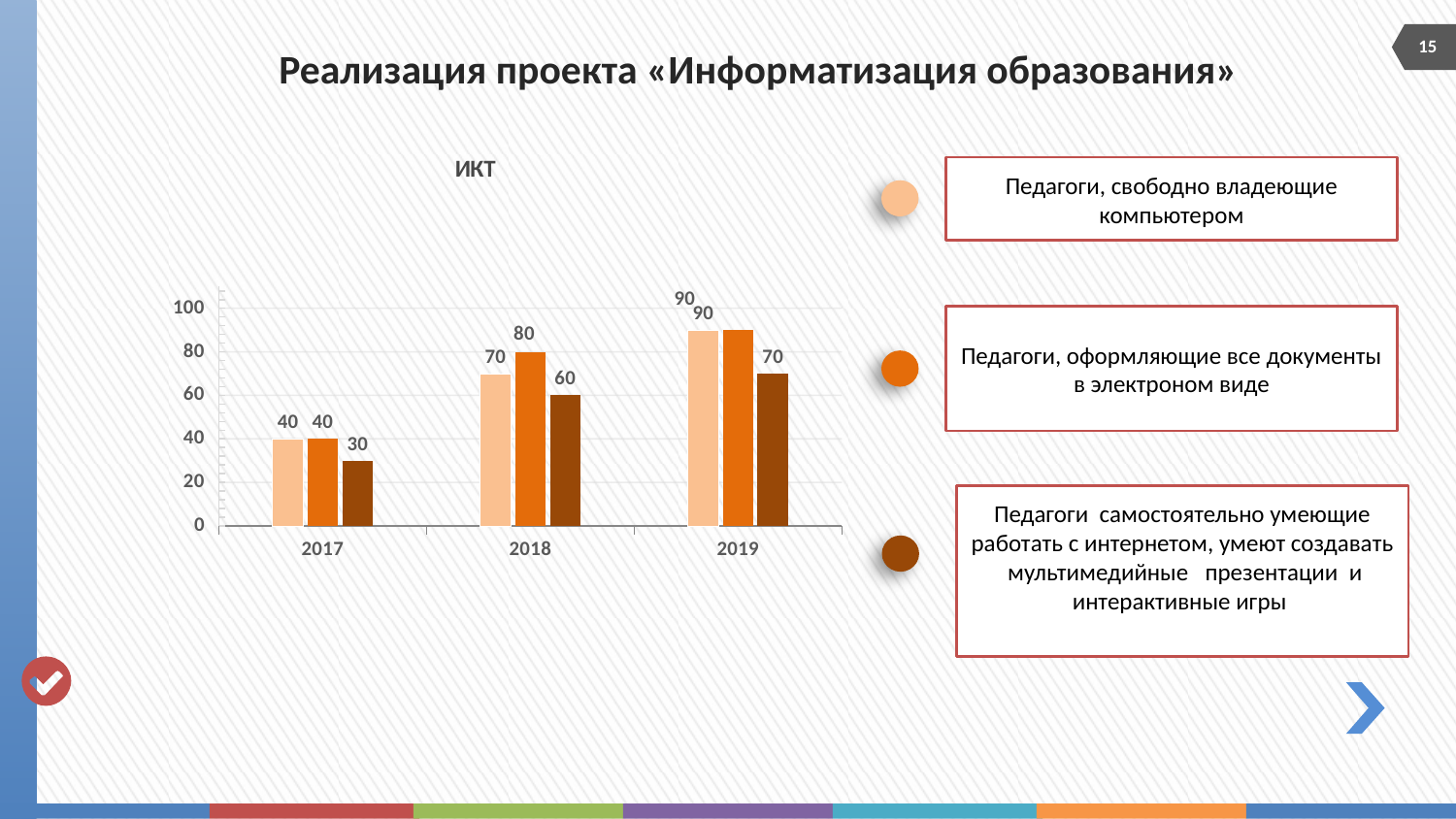
What is the difference between the orange (middle) bar and the dark brown bar in 2018? 20 What is the value of the orange (middle) bar for 2018? 80 What is the title of the chart? ИКТ What is the value of the light orange bar for 2019? 90 In which year is the dark brown bar the lowest? 2017 What kind of chart is shown on the slide? bar chart In which year is the orange (middle) bar the highest? 2019 Which is larger in 2018: the light orange bar or the orange (middle) bar? the orange (middle) bar Do the values of the light orange bars rise or fall from 2017 to 2019? rise How many years are shown on the x axis of the chart? 3 What is the value of the dark brown bar for 2017? 30 What is the value of the dark brown bar for 2019? 70